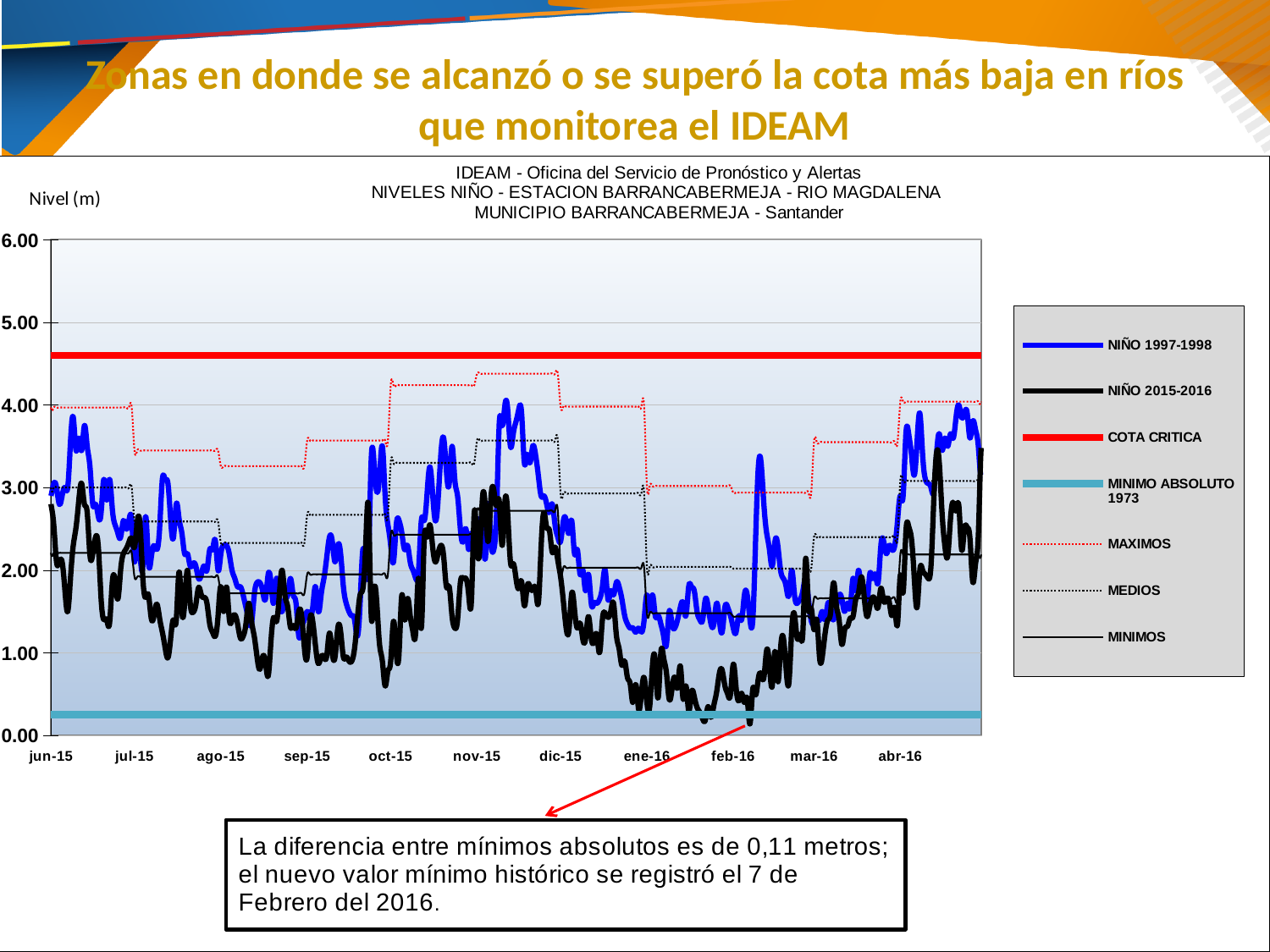
Is the value of the COTA CRITICA line greater or less than 4.00? greater Which series reaches the lowest level on the chart, NIÑO 1997-1998 or NIÑO 2015-2016? NIÑO 2015-2016 What kind of chart is shown on the slide? line chart How many month labels are shown along the x axis of the chart? 11 Is the value of the COTA CRITICA line greater or less than 5.00? less How many series does the chart legend list? 7 What is the label of the chart's y axis? Nivel (m) Is the value of the MINIMO ABSOLUTO 1973 line greater or less than 1.00? less Which line is higher on the chart, COTA CRITICA or MINIMO ABSOLUTO 1973? COTA CRITICA Around feb-16, which series is lower, NIÑO 1997-1998 or NIÑO 2015-2016? NIÑO 2015-2016 What colour is the NIÑO 2015-2016 line in the chart? black